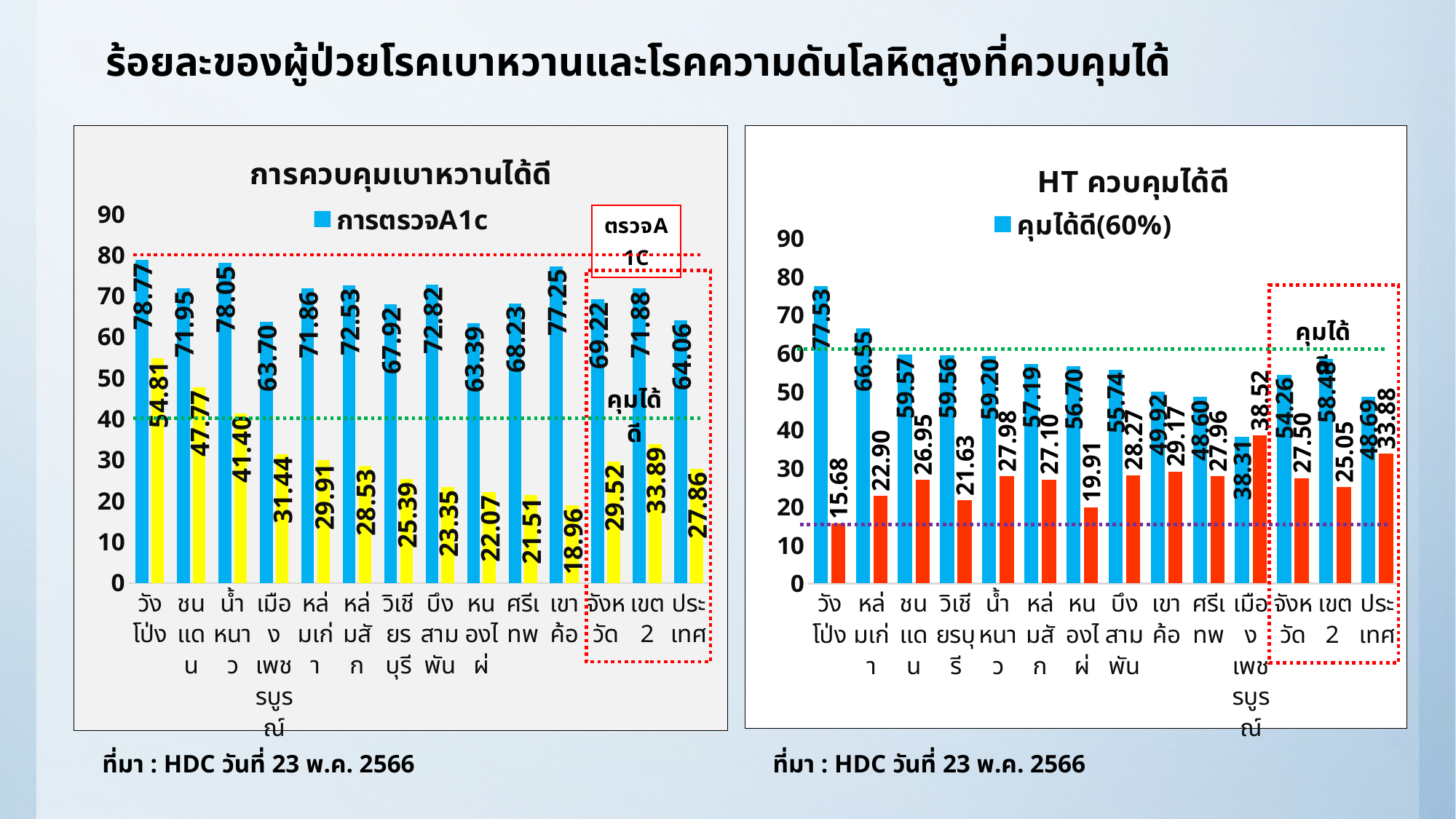
In the right chart (HT ควบคุมได้ดี), which category has the highest red bar? เมืองเพชรบูรณ์ In the right chart (HT ควบคุมได้ดี), what is the difference between the blue and red values for วังโป่ง? 61.85 In the right chart (HT ควบคุมได้ดี), which is larger, the blue value for จังหวัด or the blue value for เขต 2? เขต 2 In the left chart (การควบคุมเบาหวานได้ดี), how many categories are shown on the x axis? 14 In the left chart (การควบคุมเบาหวานได้ดี), what is the yellow value for เขต 2? 33.89 In the right chart (HT ควบคุมได้ดี), which category has the lowest blue bar? เมืองเพชรบูรณ์ What type of chart is the left chart (การควบคุมเบาหวานได้ดี)? Bar chart In the right chart (HT ควบคุมได้ดี), what is the blue value for วังโป่ง? 77.53 In the left chart (การควบคุมเบาหวานได้ดี), what is the difference between the blue and yellow values for ประเทศ? 36.20 In the left chart (การควบคุมเบาหวานได้ดี), what is the blue (การตรวจA1c) value for วังโป่ง? 78.77 In the right chart (HT ควบคุมได้ดี), what is the red value for ประเทศ? 33.88 In the left chart (การควบคุมเบาหวานได้ดี), which category has the lowest yellow bar? เขาค้อ